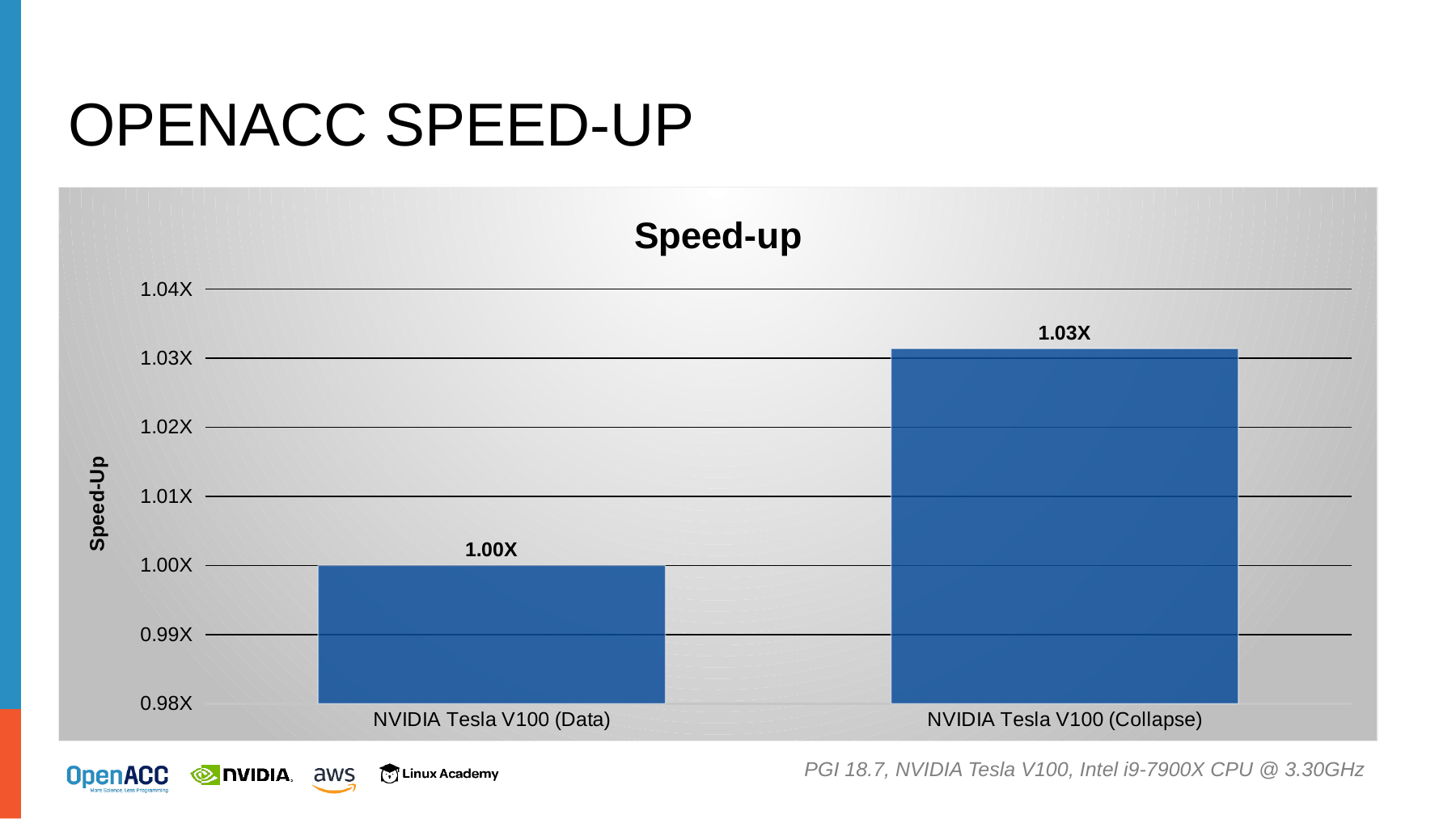
Which is larger, the speed-up for NVIDIA Tesla V100 (Data) or for NVIDIA Tesla V100 (Collapse)? NVIDIA Tesla V100 (Collapse) Is the speed-up for NVIDIA Tesla V100 (Collapse) greater or less than 1.02X? greater What is the title of the chart? Speed-up Which category has the highest speed-up? NVIDIA Tesla V100 (Collapse) Do the values rise or fall from left to right along the x axis? rise Which category has the lowest speed-up? NVIDIA Tesla V100 (Data) What kind of chart is shown on the slide? bar chart What is the speed-up value for NVIDIA Tesla V100 (Data)? 1.00X What is the label on the y axis of the chart? Speed-Up How many categories are shown on the chart? 2 What is the speed-up value for NVIDIA Tesla V100 (Collapse)? 1.03X What is the difference in speed-up between NVIDIA Tesla V100 (Collapse) and NVIDIA Tesla V100 (Data)? 0.03X